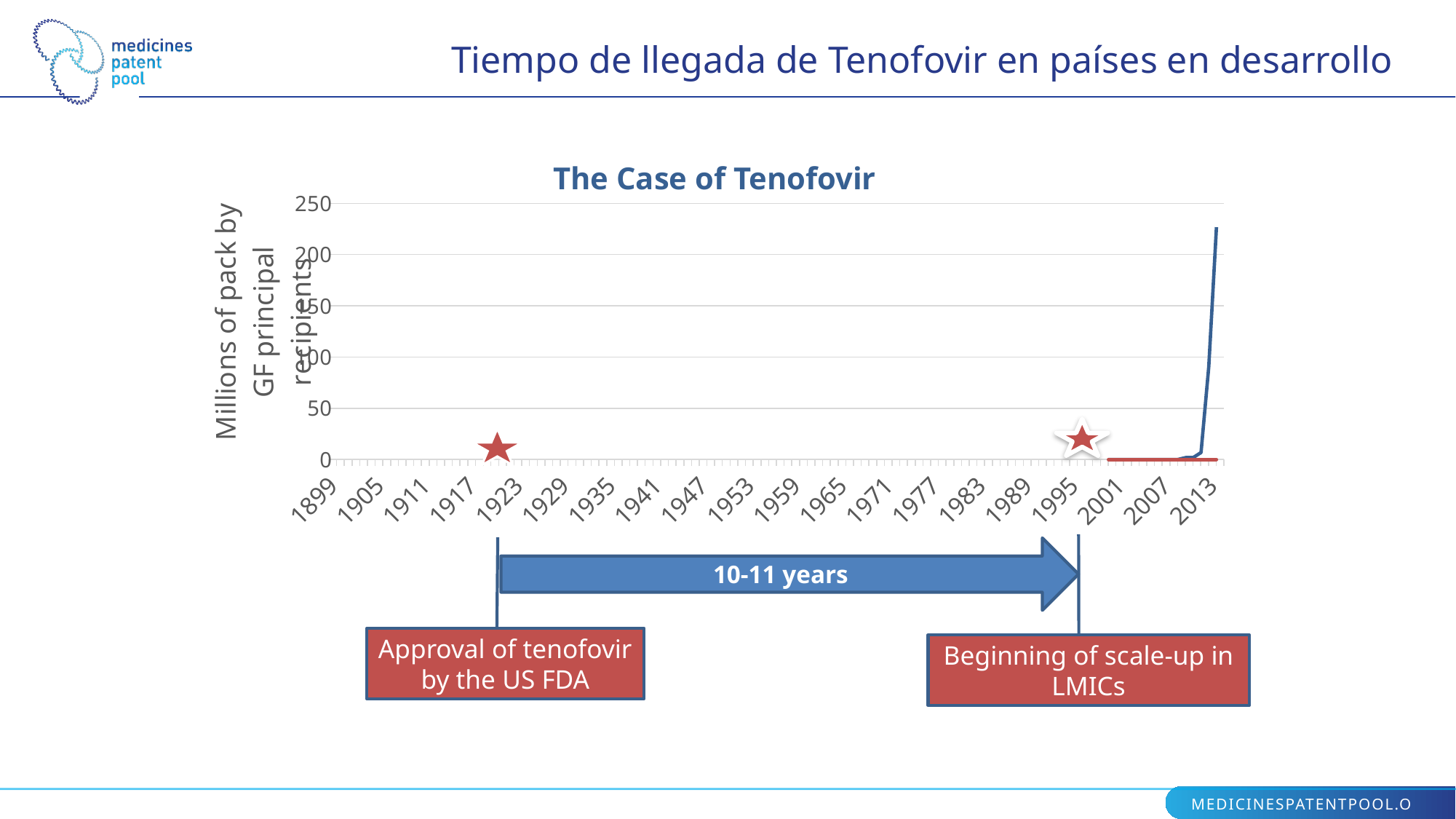
What is the first year label on the horizontal axis? 1899 Is the value for 2007 greater or less than 50? less What is the label on the vertical axis of the chart? Millions of pack by GF principal recipients Is the value at the final point of the line (around 2013) greater or less than 200? greater What is the title of the chart? The Case of Tenofovir What kind of chart is shown on the slide? Line chart Does the line rise or fall at the right-hand end of the x axis, after 2013? Rises What is the last year label on the horizontal axis? 2013 What is the highest value shown on the vertical axis? 250 Is the value for 2001 greater or less than 50? less